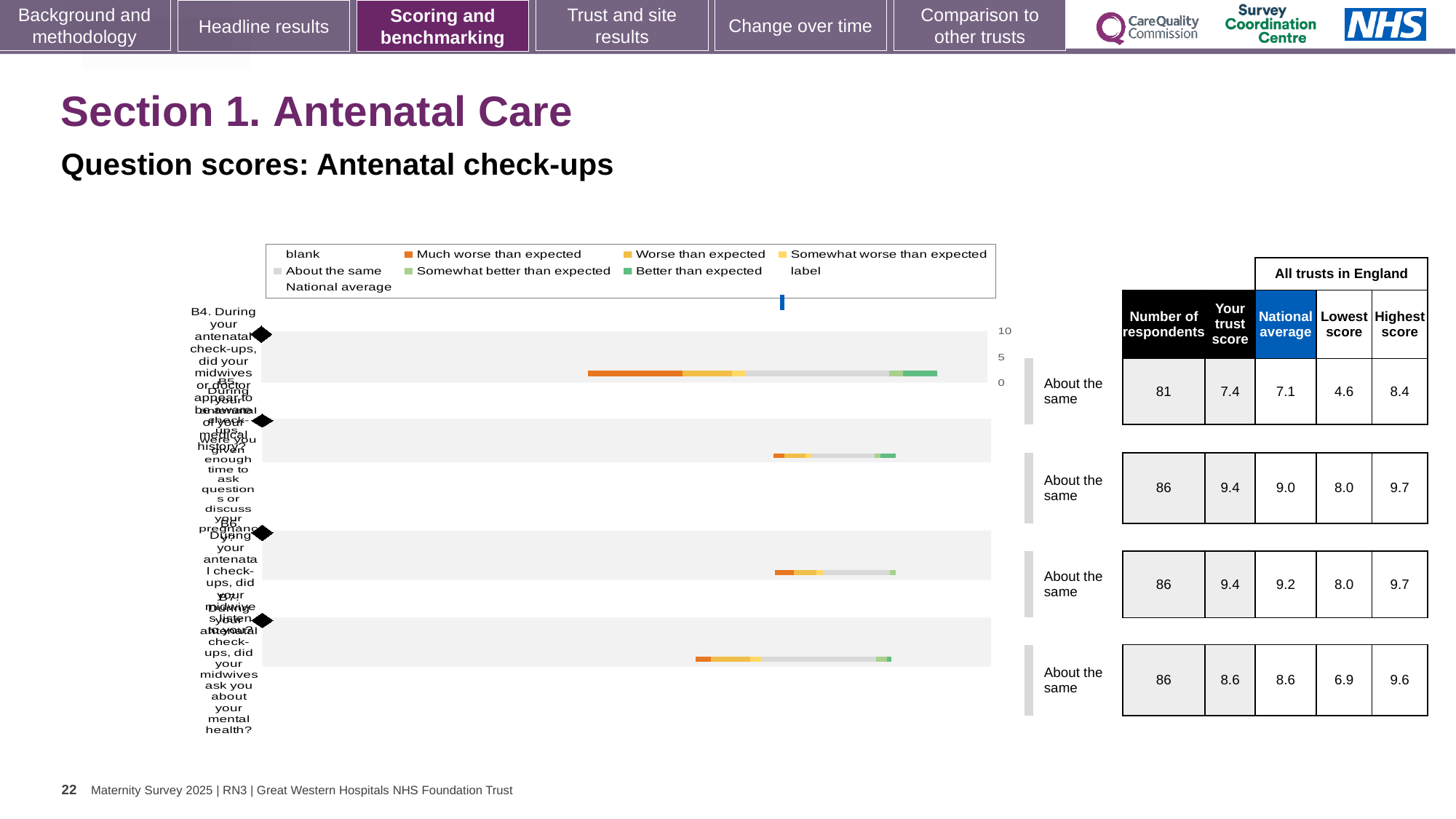
What kind of chart is shown on the slide? bar chart In the table beside the chart, what is the number of respondents for the first question (B4)? 81 In the table beside the chart, what is the national average for the first question (B4)? 7.1 What is the highest value shown on the chart's axis? 10 Which legend entry in the chart is shown in orange? Much worse than expected What benchmark category is shown for every question in the chart? About the same How many question bars are plotted in the chart? 4 In the table beside the chart, what is the difference between the highest score and lowest score for the first question (B4)? 3.8 In the table beside the chart, what is the lowest score for the last question (B7)? 6.9 In the table beside the chart, is the trust score for the second question (B5) larger or smaller than its national average? larger In the table beside the chart, what is the trust score for the first question (B4)? 7.4 In the table beside the chart, which question has the lowest trust score? B4